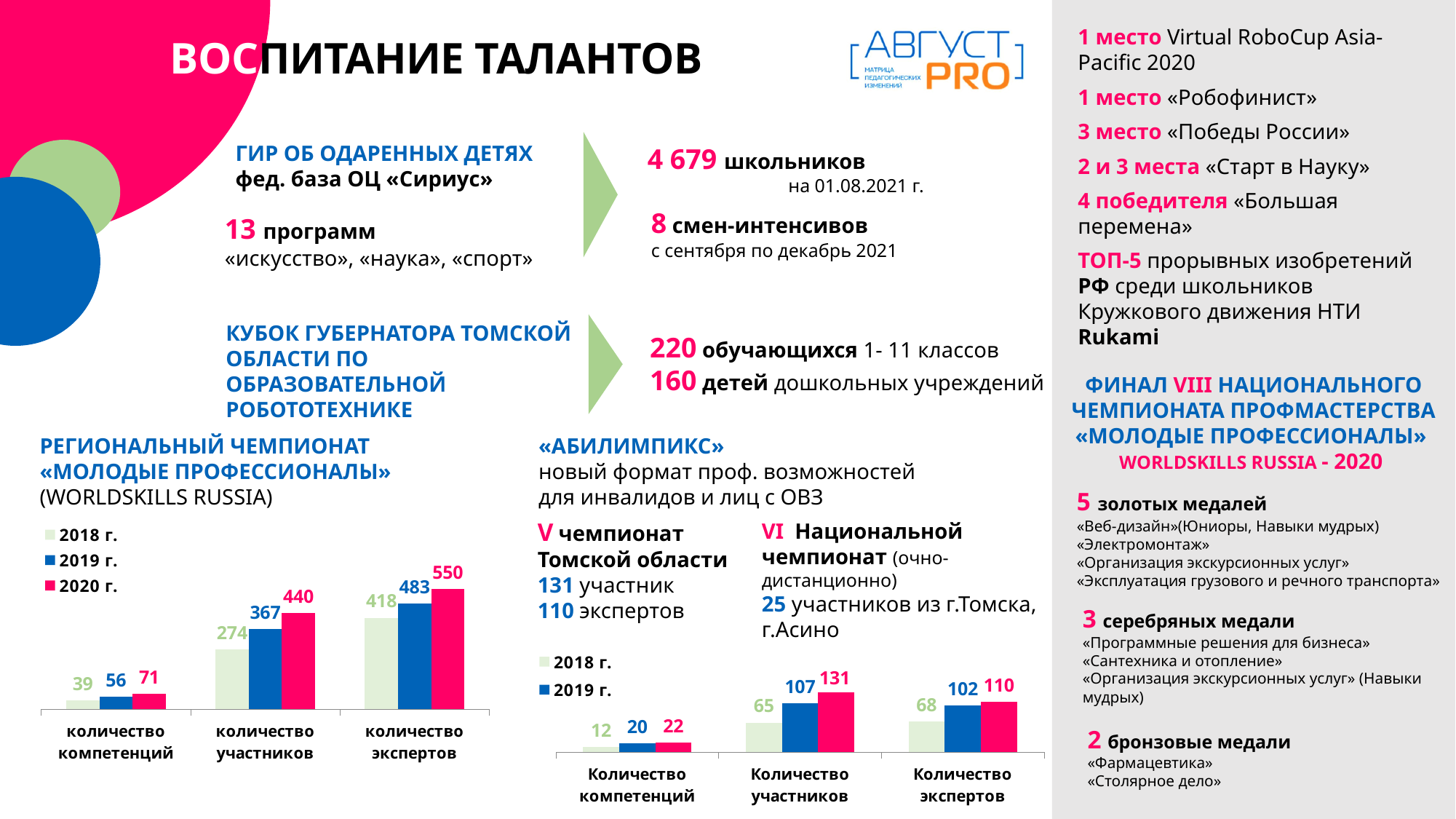
How many categories are shown on the x axis of the right chart («Абилимпикс»)? 3 In the left chart (Региональный чемпионат «Молодые профессионалы»), what is the difference between the 2020 г. and 2018 г. values for «количество компетенций»? 32 In the left chart (Региональный чемпионат «Молодые профессионалы»), what is the value for 2018 г. in the category «количество экспертов»? 418 In the right chart («Абилимпикс»), what is the value for 2018 г. in the category «Количество компетенций»? 12 In the right chart («Абилимпикс»), which is larger: the 2019 г. value for «Количество участников» or the 2019 г. value for «Количество экспертов»? Количество участников In the left chart (Региональный чемпионат «Молодые профессионалы»), what is the value for 2020 г. in the category «количество участников»? 440 In the right chart («Абилимпикс»), what is the value for 2019 г. in the category «Количество участников»? 107 What kind of chart is the left chart (Региональный чемпионат «Молодые профессионалы»)? bar chart In the left chart (Региональный чемпионат «Молодые профессионалы»), do the values for «количество участников» rise or fall from 2018 г. to 2020 г.? rise How many series does the legend of the left chart (Региональный чемпионат «Молодые профессионалы») list? 3 In the right chart («Абилимпикс»), which category has the lowest value for 2018 г.? Количество компетенций In the left chart (Региональный чемпионат «Молодые профессионалы»), which category has the highest value for 2019 г.? количество экспертов